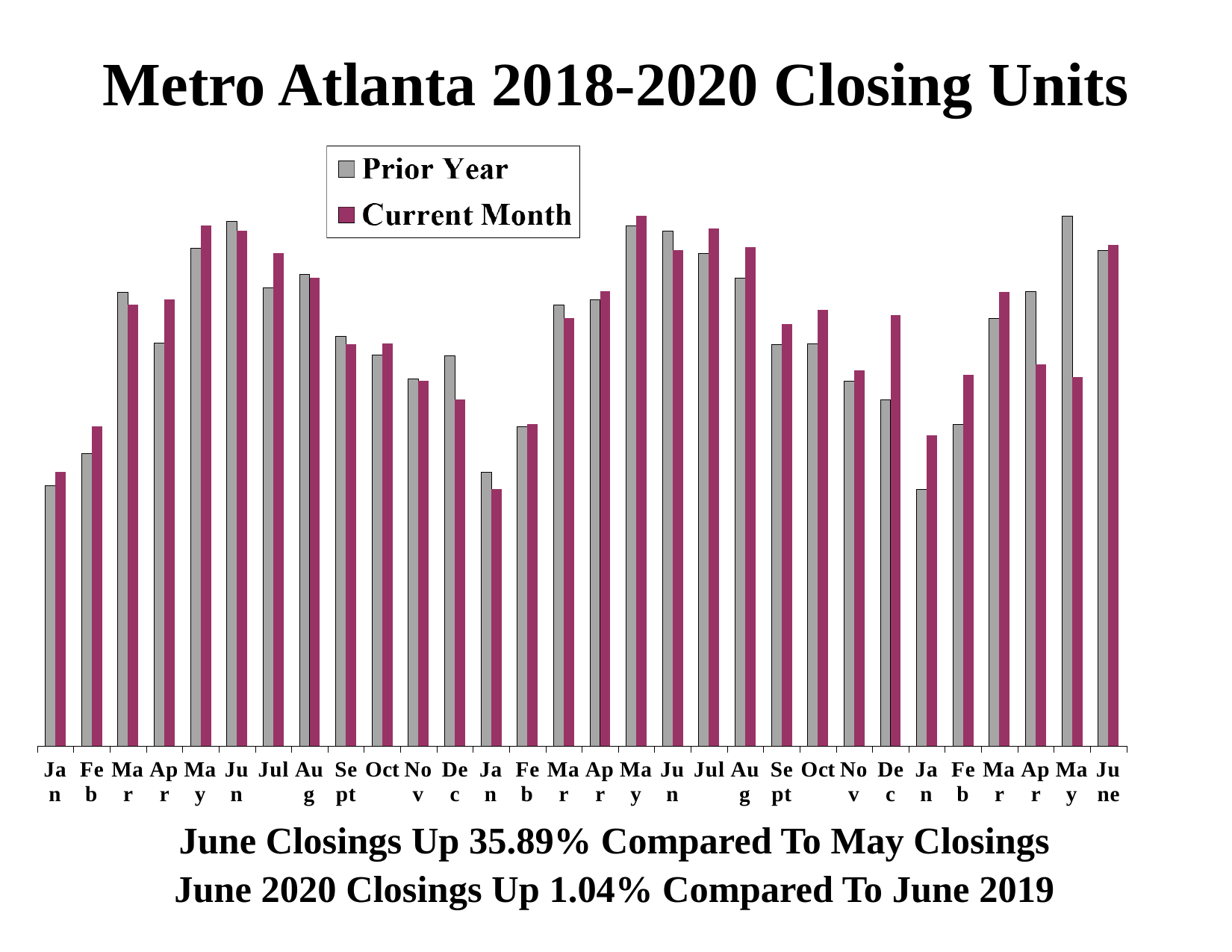
Which month has the tallest Current Month bar? The second May How many series does the legend list? 2 For the last May on the x axis, which is larger: the Prior Year bar or the Current Month bar? Prior Year How many month categories are shown along the x axis? 30 Do the Current Month bars rise or fall from the first Jun to the first Dec on the x axis? Fall For the first Jan on the x axis, which is larger: the Prior Year bar or the Current Month bar? Current Month For the second Dec on the x axis, which is larger: the Prior Year bar or the Current Month bar? Current Month Do the Prior Year bars rise or fall from the first Jan to the first Jun on the x axis? Rise What kind of chart is shown on the slide? Bar chart What are the two series named in the legend? Prior Year and Current Month What is the title of the chart? Metro Atlanta 2018-2020 Closing Units